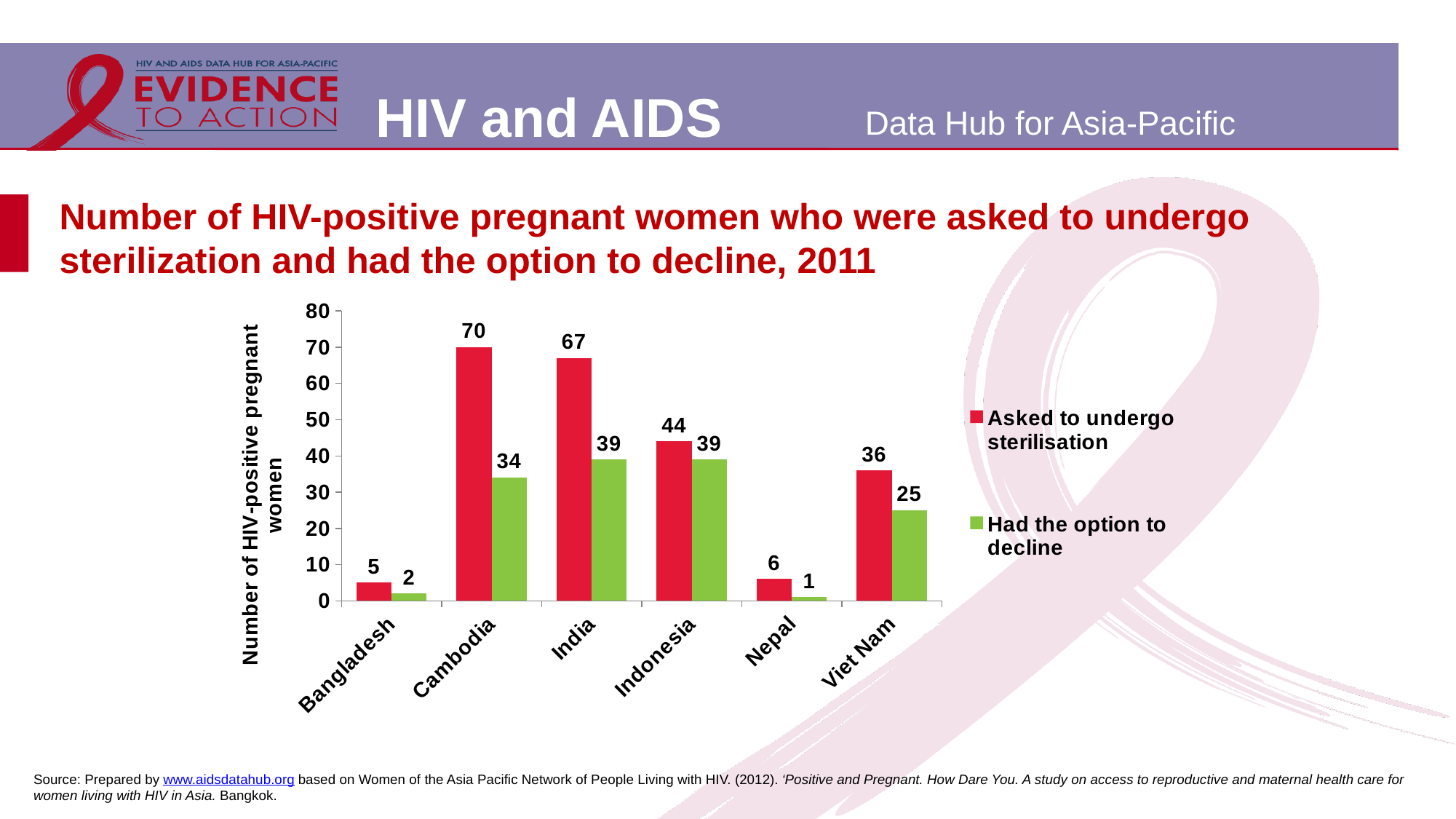
Which country has the highest number of women asked to undergo sterilisation? Cambodia What is the value for Nepal in the 'Had the option to decline' series? 1 How many series does the legend list? 2 What colour represents the 'Had the option to decline' series? Green What is the difference between India's and Indonesia's values for 'Asked to undergo sterilisation'? 23 Which country has the lowest number of women who had the option to decline? Nepal What kind of chart is shown on the slide? Bar chart How many HIV-positive pregnant women in Cambodia were asked to undergo sterilisation? 70 How many HIV-positive pregnant women in Viet Nam had the option to decline? 25 How many countries are shown on the x axis of the chart? 6 What is the difference between the number asked to undergo sterilisation and the number who had the option to decline in Cambodia? 36 Which is larger: the number asked to undergo sterilisation in Viet Nam or in Indonesia? Indonesia